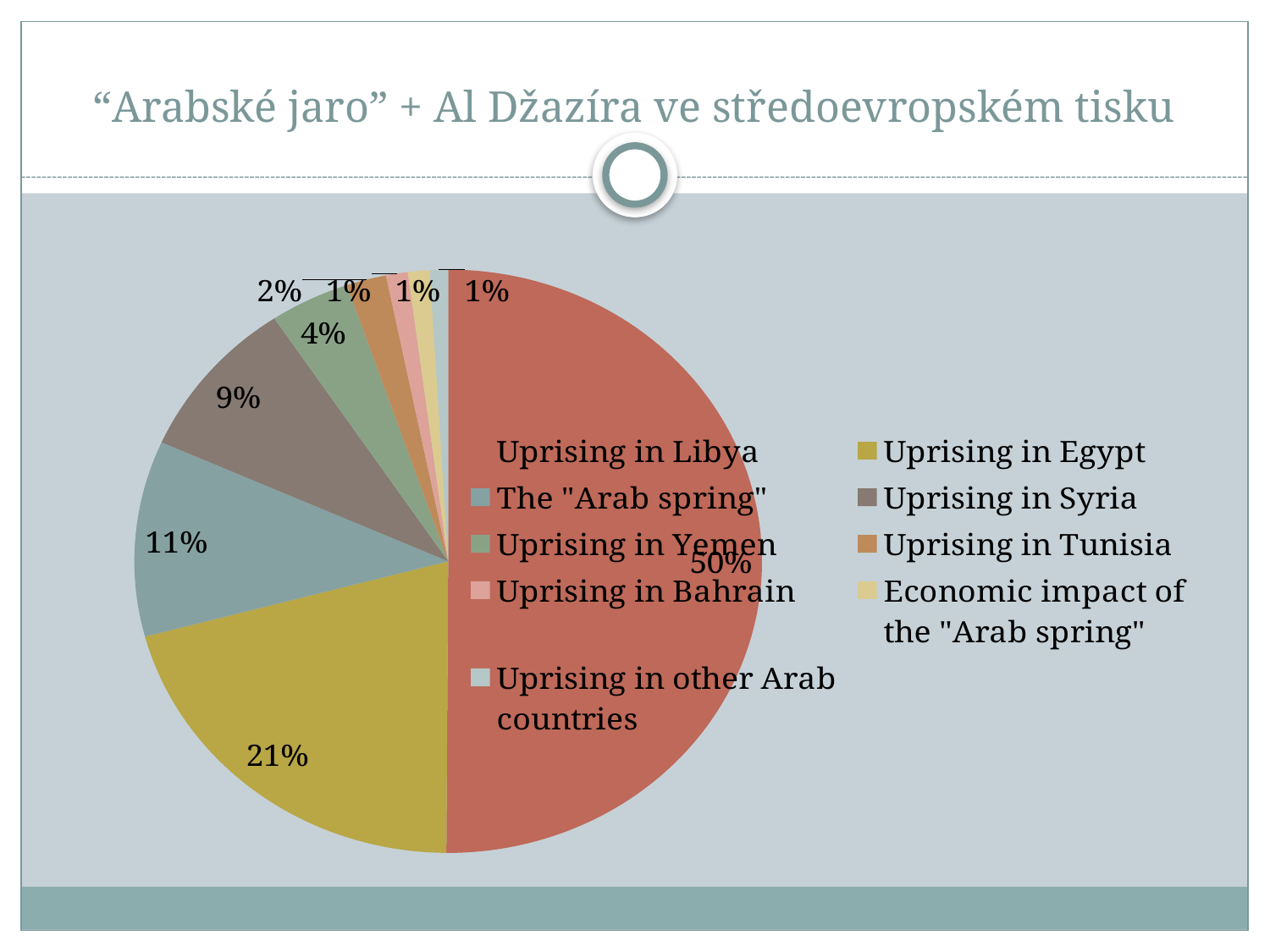
What share does The "Arab spring" slice represent? 11% What share of the pie does Uprising in Libya account for? 50% What is the difference in percentage points between Uprising in Libya and Uprising in Egypt? 29 Which category has the largest slice of the pie? Uprising in Libya What percentage is shown for Uprising in Tunisia? 2% What is the combined share of Uprising in Egypt and The "Arab spring"? 32% What percentage is labelled for Uprising in Syria? 9% How many categories does the legend list? 9 What share of the pie is Uprising in Yemen? 4% Which is larger, the slice for Uprising in Syria or the slice for Uprising in Yemen? Uprising in Syria What percentage is shown for Uprising in Egypt? 21% What type of chart is shown on the slide? Pie chart